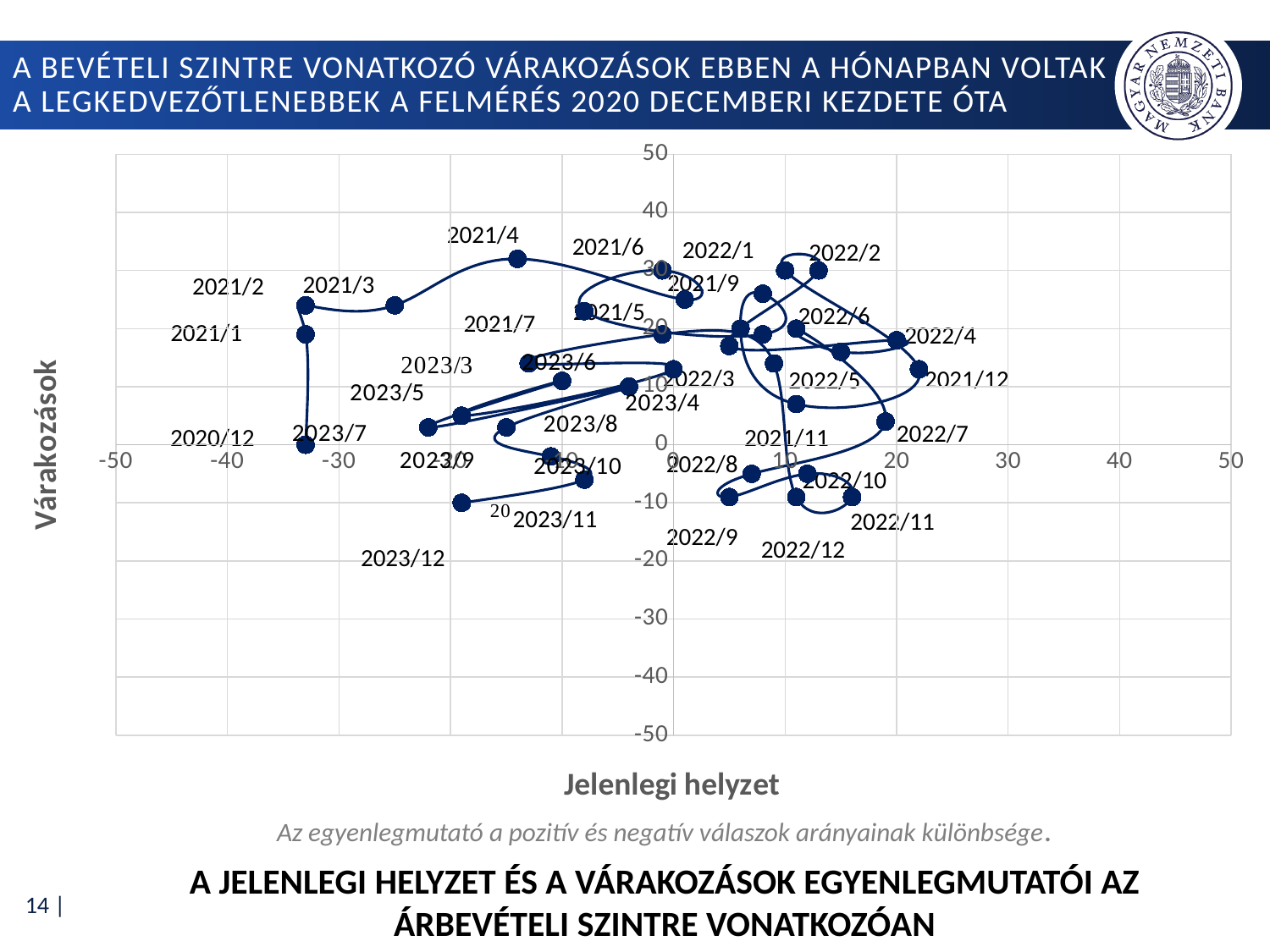
Is the Jelenlegi helyzet value for 2022/2 greater or less than 0? greater Is the Várakozások value for 2022/2 greater or less than 20? greater Is the Várakozások value for 2022/9 greater or less than 0? less What is the title of the vertical axis? Várakozások What is the title of the horizontal axis? Jelenlegi helyzet What kind of chart is shown on the slide? scatter chart with connected points